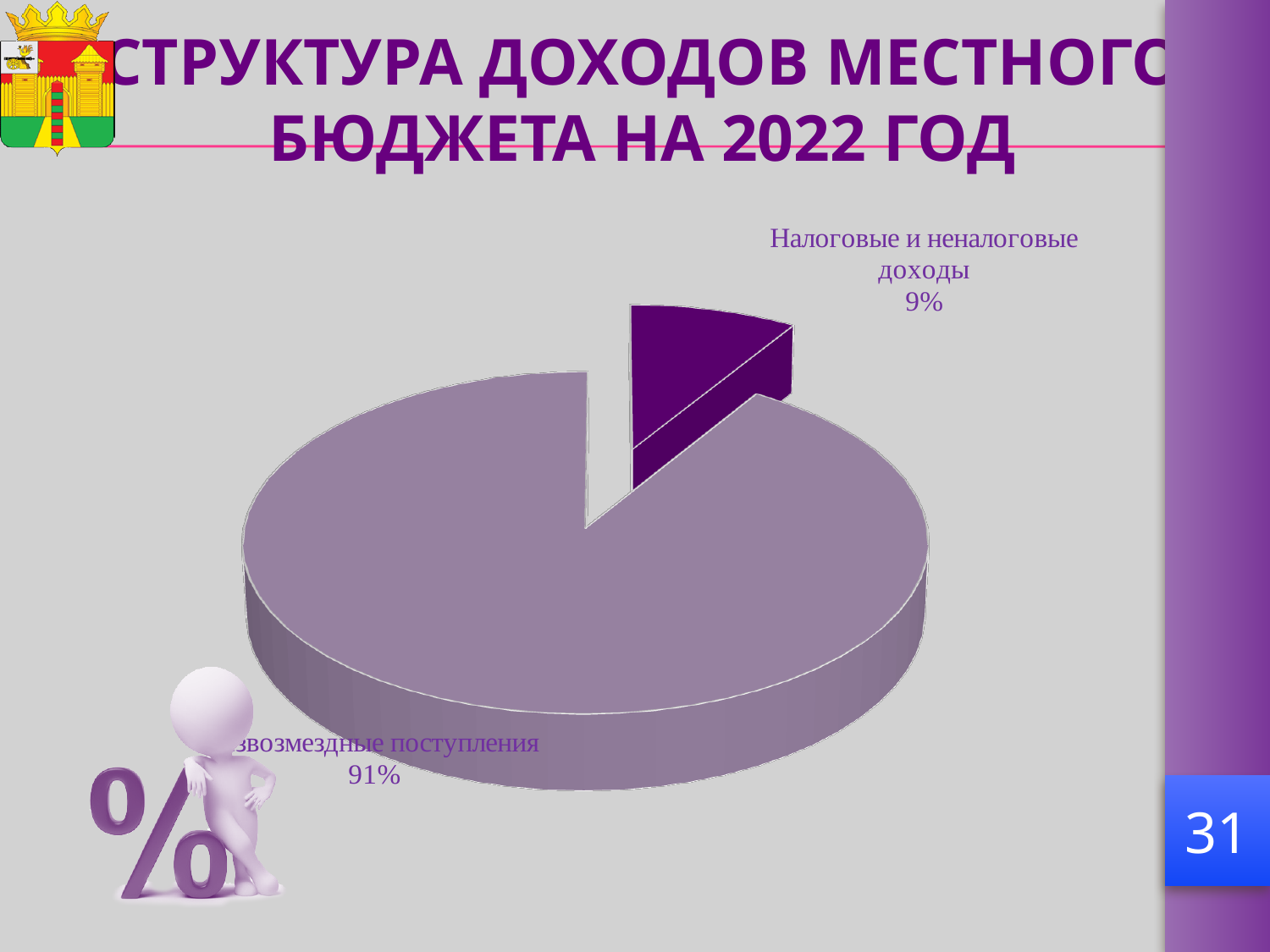
What is the total of the two slice percentages shown on the pie chart? 100% Which slice of the pie is the smallest? Налоговые и неналоговые доходы Which year does the chart's title refer to? 2022 What kind of chart is shown on the slide? Pie chart Which is larger: the share for "Налоговые и неналоговые доходы" or the share for "Безвозмездные поступления"? Безвозмездные поступления Which slice of the pie is the largest? Безвозмездные поступления How many slices does the pie chart have? 2 What is the title of the slide containing the pie chart? СТРУКТУРА ДОХОДОВ МЕСТНОГО БЮДЖЕТА НА 2022 ГОД What is the difference in percentage points between the "Безвозмездные поступления" slice and the "Налоговые и неналоговые доходы" slice? 82 percentage points What share of the pie does "Налоговые и неналоговые доходы" represent? 9% What share of the pie does "Безвозмездные поступления" represent? 91%